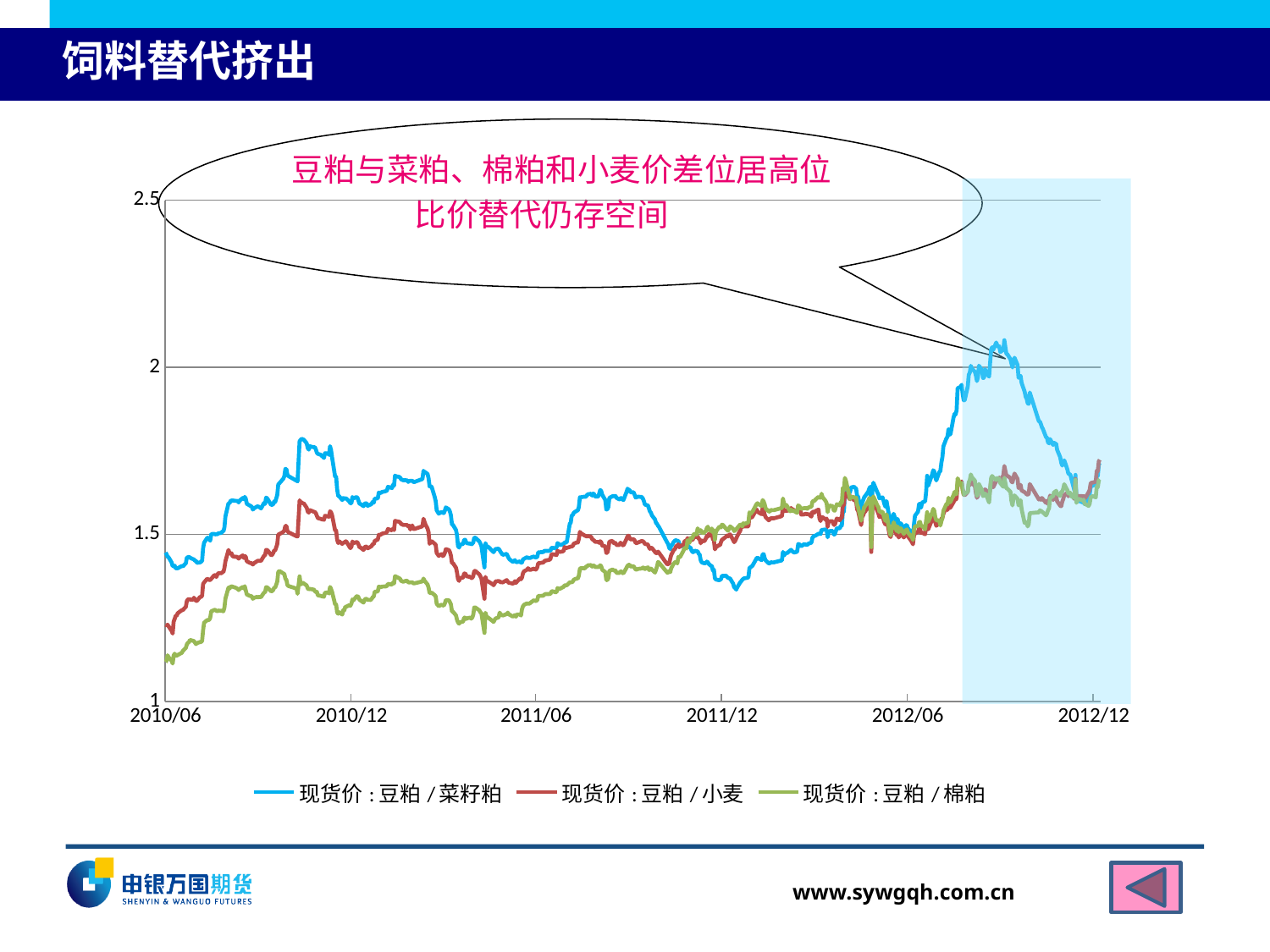
Which series is drawn in green according to the legend? 现货价:豆粕/棉粕 Is the value of the 现货价:豆粕/小麦 series at 2012/12 greater or less than 1.5? greater Is the value of the 现货价:豆粕/棉粕 series at 2010/06 greater or less than 1.5? less Is the peak value of the 现货价:豆粕/菜籽粕 series around 2012/09 greater or less than 2? greater Which series has the lowest value at 2010/06? 现货价:豆粕/棉粕 Which series is drawn in blue according to the legend? 现货价:豆粕/菜籽粕 At 2010/06, which is larger: the 现货价:豆粕/小麦 series or the 现货价:豆粕/棉粕 series? 现货价:豆粕/小麦 How many series does the legend list? 3 Does the 现货价:豆粕/棉粕 series rise or fall overall from 2010/06 to 2012/12? rise Which series has the highest value at 2010/06? 现货价:豆粕/菜籽粕 What kind of chart is shown on the slide? line chart